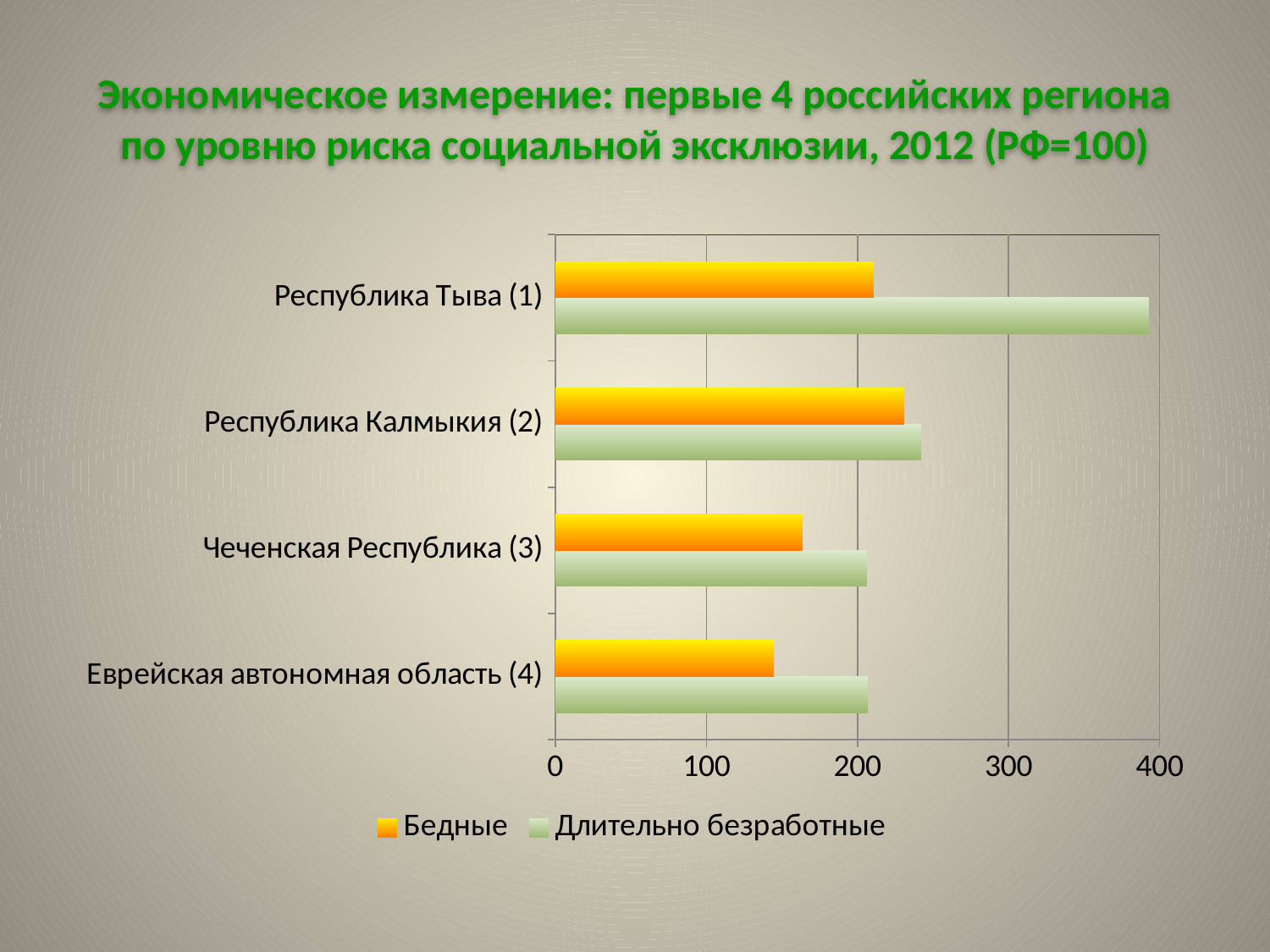
Is the value for Бедные in Республика Калмыкия (2) greater or less than 200? greater How many regions (categories) are shown in the chart? 4 Is the value for Бедные in Еврейская автономная область (4) greater or less than 200? less Which is larger: the Бедные value for Республика Калмыкия (2) or for Чеченская Республика (3)? Республика Калмыкия (2) For Республика Тыва (1), which series has the larger value: Бедные or Длительно безработные? Длительно безработные What kind of chart is shown on the slide? bar chart Which colour represents the Бедные series in the chart? orange Is the value for Длительно безработные in Республика Тыва (1) greater or less than 300? greater Which region has the lowest value for Бедные? Еврейская автономная область (4) How many series does the legend list? 2 Which region has the highest value for Длительно безработные? Республика Тыва (1) Which region has the highest value for Бедные? Республика Калмыкия (2)